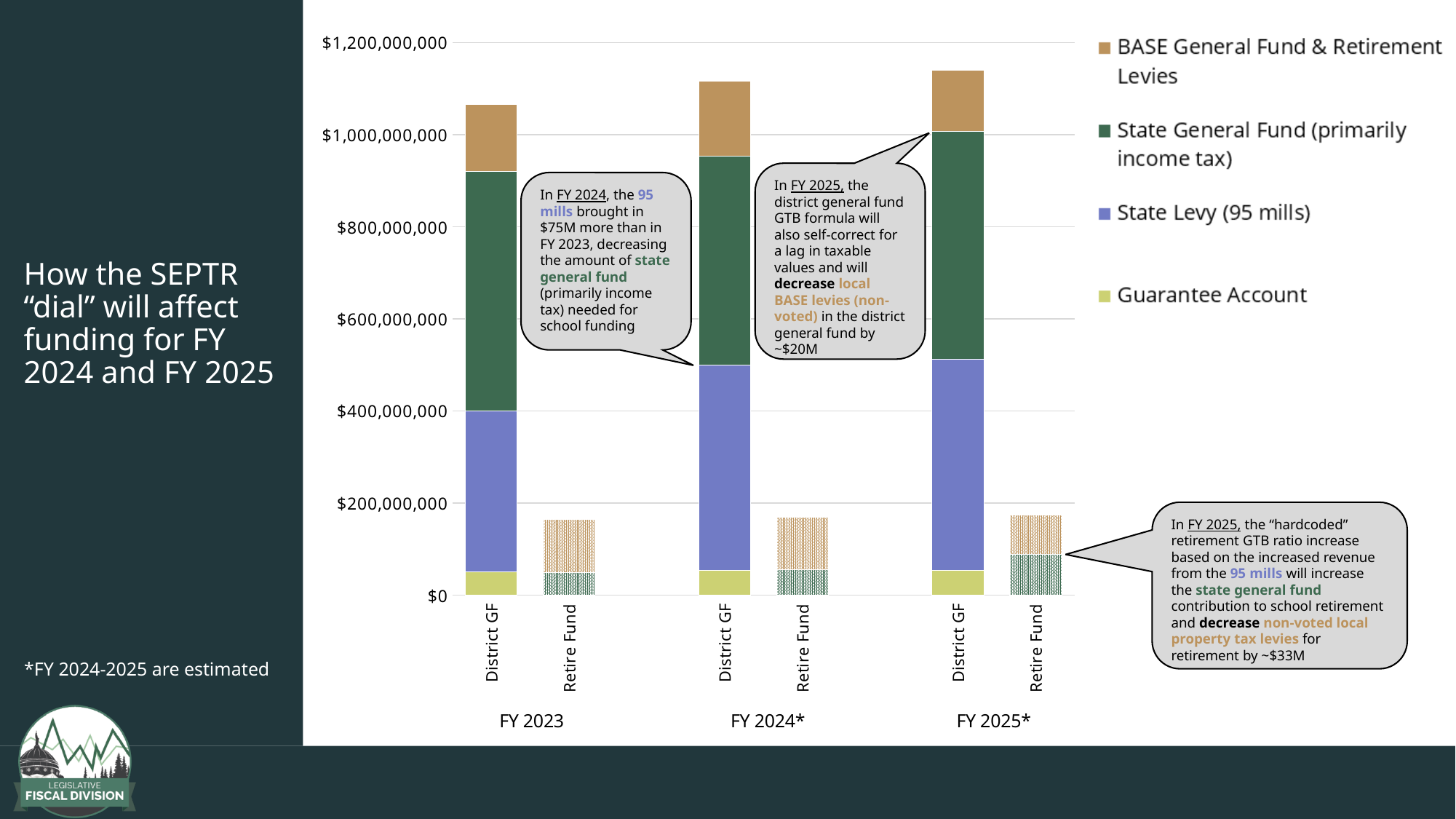
Among the District GF bars, which fiscal year has the tallest bar? FY 2025* Which series is shown at the bottom of each stacked bar? Guarantee Account for the District GF bars; State General Fund (primarily income tax) for the Retire Fund bars How many series does the chart legend list? 4 Is the total of the Retire Fund bar for FY 2023 greater or less than $200,000,000? less Is the total of the Retire Fund bar for FY 2025* greater or less than $200,000,000? less Is the total of the District GF bar for FY 2023 greater or less than $1,000,000,000? greater Which is larger, the District GF bar for FY 2025* or the District GF bar for FY 2023? District GF for FY 2025* Do the District GF bar totals rise or fall from FY 2023 to FY 2025*? Rise What kind of chart is shown on the slide? Stacked bar chart Which fiscal years are shown along the x axis of the chart? FY 2023, FY 2024*, FY 2025* How many bars are plotted in the chart? 6